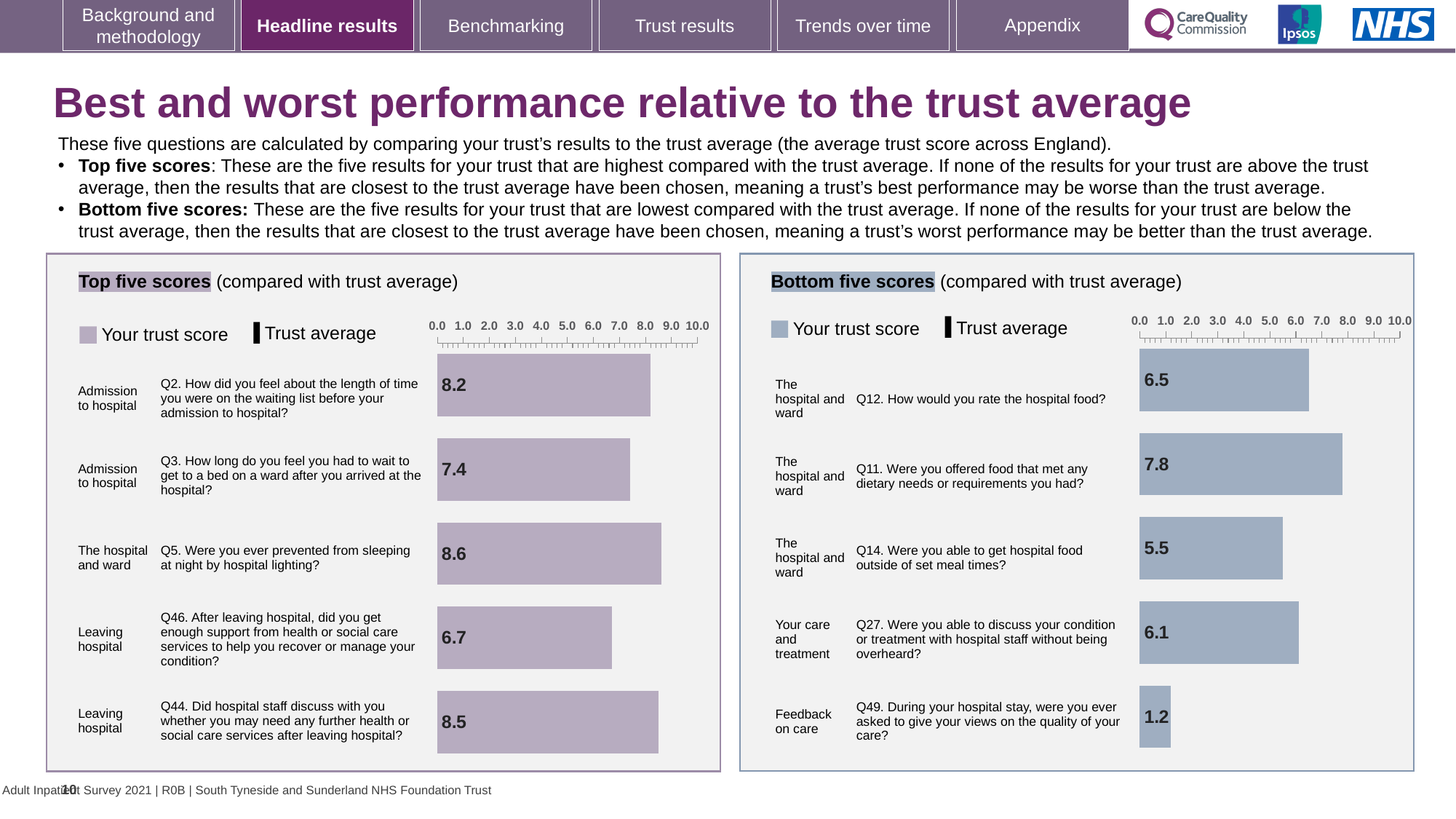
In the Bottom five scores chart, is the trust score for Q49 greater or less than 2.0? less What kind of chart is the Top five scores chart? bar chart In the Bottom five scores chart, what is the difference between the trust scores for Q11 and Q14? 2.3 How many questions are shown in the Bottom five scores chart? 5 In the Top five scores chart, which has the larger trust score, Q2 or Q44? Q44 In the Bottom five scores chart, which question has the lowest trust score? Q49 In the Top five scores chart, which question has the lowest trust score? Q46 In the Top five scores chart, which question has the highest trust score? Q5 In the Bottom five scores chart, which question has the highest trust score? Q11 In the Top five scores chart, what is the trust score for Q5 (Were you ever prevented from sleeping at night by hospital lighting?)? 8.6 In the Top five scores chart, what is the difference between the trust scores for Q2 and Q3? 0.8 In the Bottom five scores chart, what is the trust score for Q49 (During your hospital stay, were you ever asked to give your views on the quality of your care?)? 1.2